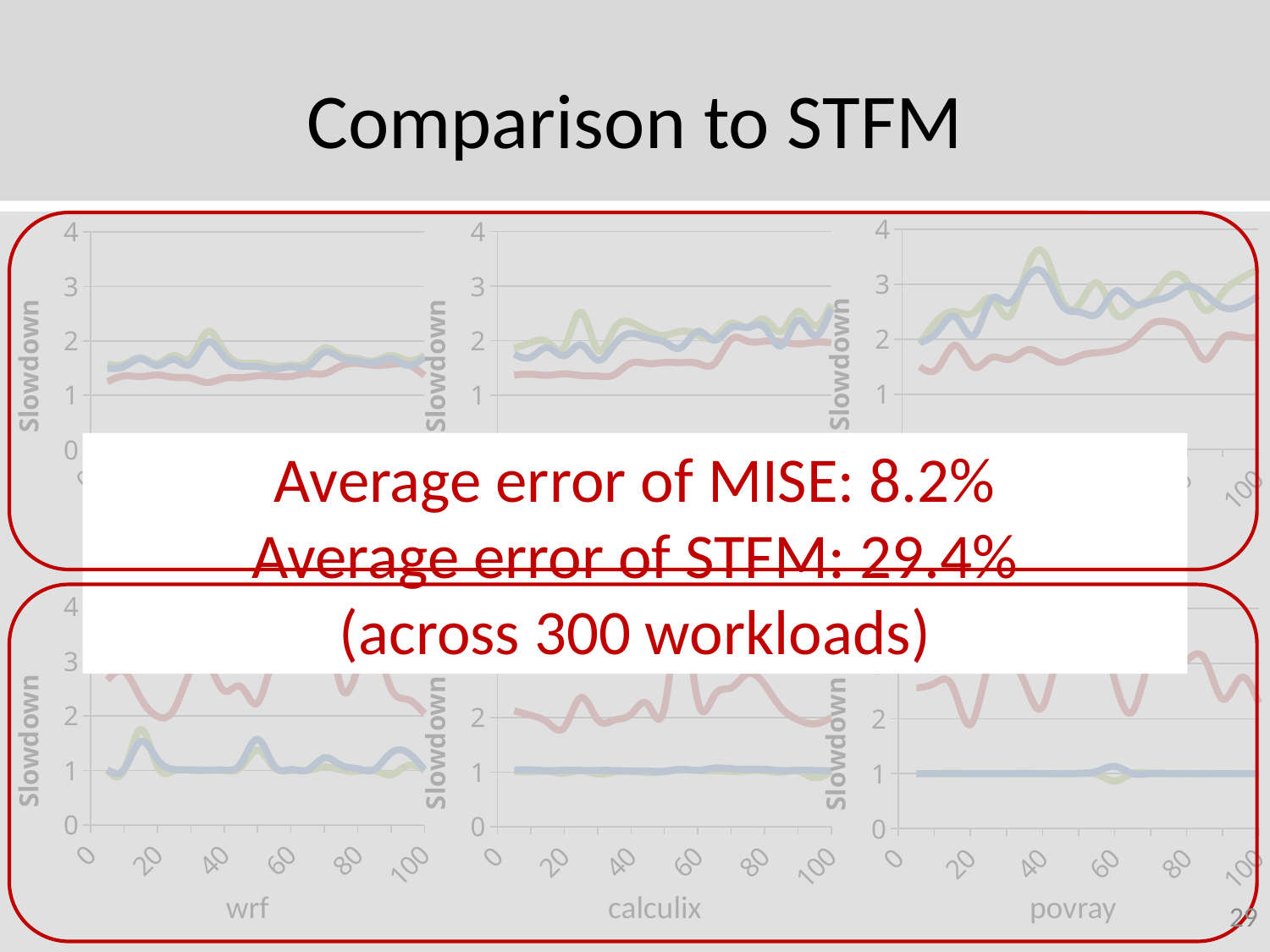
In the bottom-left chart labelled wrf, is the blue line's value at x = 20 greater or less than 2? less What kind of chart is the bottom-left chart labelled wrf? line chart In the bottom-middle chart labelled calculix, is the red line's value at x = 60 greater or less than 2? greater In the bottom-right chart labelled povray, is the blue line's value at x = 80 greater or less than 2? less How many charts are shown on the slide? 6 What is the y-axis label on the bottom-middle chart labelled calculix? Slowdown What is the x-axis title of the bottom-right chart? povray In the top-right chart, does the blue line generally rise or fall from x = 0 to x = 100? rise How many lines are plotted in the bottom-left chart labelled wrf? 3